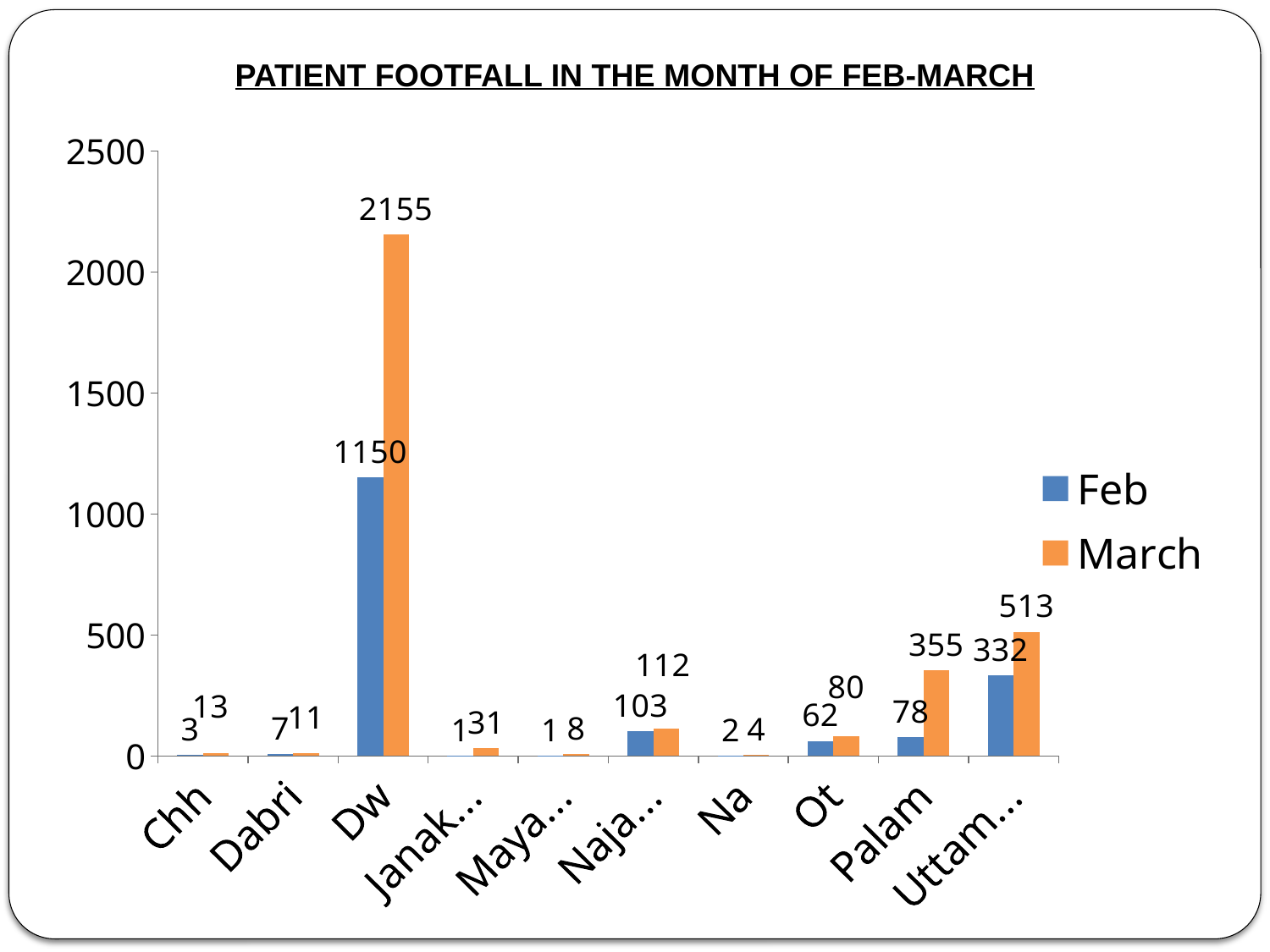
How many series does the legend list? 2 What is the Feb value for Dw? 1150 What is the Feb value for Ot? 62 What is the March value for Palam? 355 What is the difference between the March and Feb values for Palam? 277 What is the difference between the March and Feb values for Dw? 1005 Which category has the highest March value? Dw Is the March value for Dw greater or less than 2000? greater What is the March value for Dw? 2155 What kind of chart is shown on the slide? bar chart How many categories are shown on the x axis? 10 Which is larger, the March value for Palam or the March value for Ot? Palam